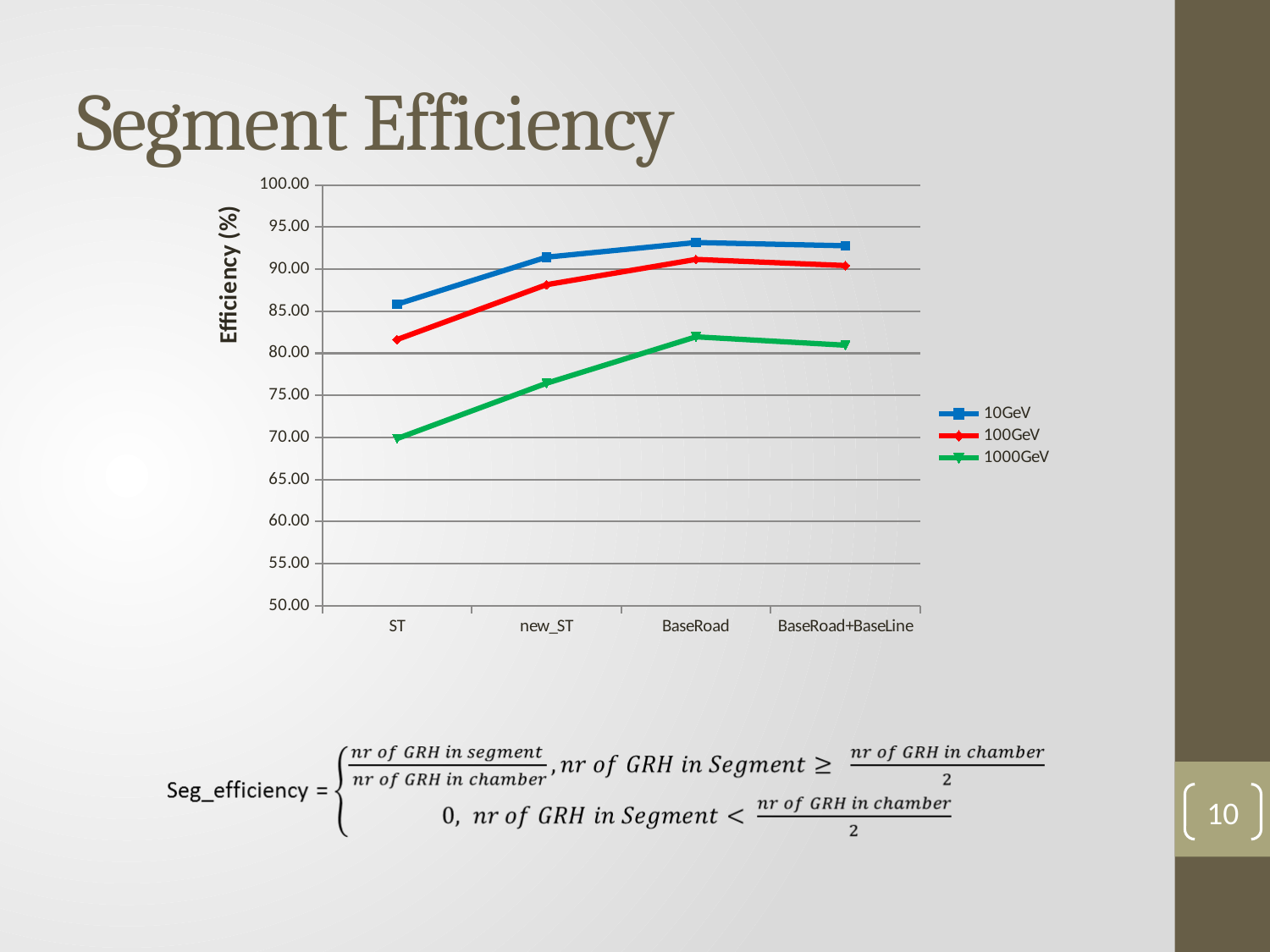
Which is larger at ST: the 10GeV value or the 1000GeV value? 10GeV For the 1000GeV series, which category has the lowest efficiency? ST How many series does the legend list? 3 What kind of chart is shown on the slide? line chart Does the 100GeV series rise or fall from ST to new_ST? rise Which series has the lowest efficiency across all categories? 1000GeV How many categories are shown on the x axis? 4 Is the value for 10GeV at BaseRoad greater or less than 95.00? less Is the value for 1000GeV at new_ST greater or less than 75.00? greater For the 1000GeV series, which category has the highest efficiency? BaseRoad Is the value for 100GeV at ST greater or less than 80.00? greater What is the label of the y axis? Efficiency (%)